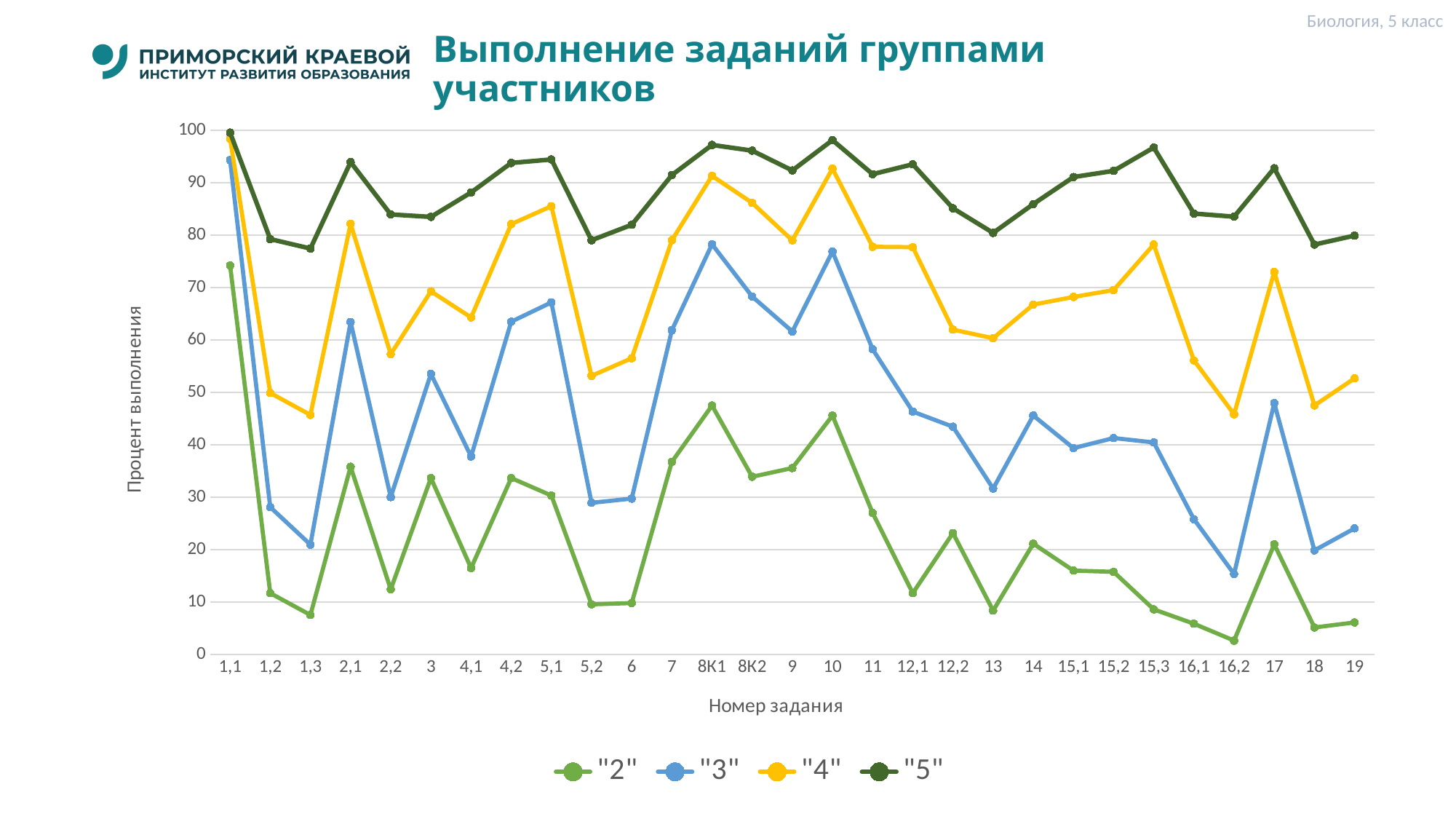
Is the value for series "4" at task 1,3 greater or less than 50? less For series "4", which is larger: the value at task 2,1 or at task 2,2? 2,1 Is the value for series "3" at task 8К1 greater or less than 70? greater At which task does series "2" reach its lowest value? 16,2 Is the value for series "5" at task 10 greater or less than 90? greater How many task numbers (categories) are plotted along the x axis? 29 At which task does series "3" reach its highest value? 1,1 What kind of chart is shown on the slide? Line chart How many series does the legend list? 4 What is the title of the vertical axis? Процент выполнения Does series "2" rise or fall from task 1,1 to task 1,3? Fall